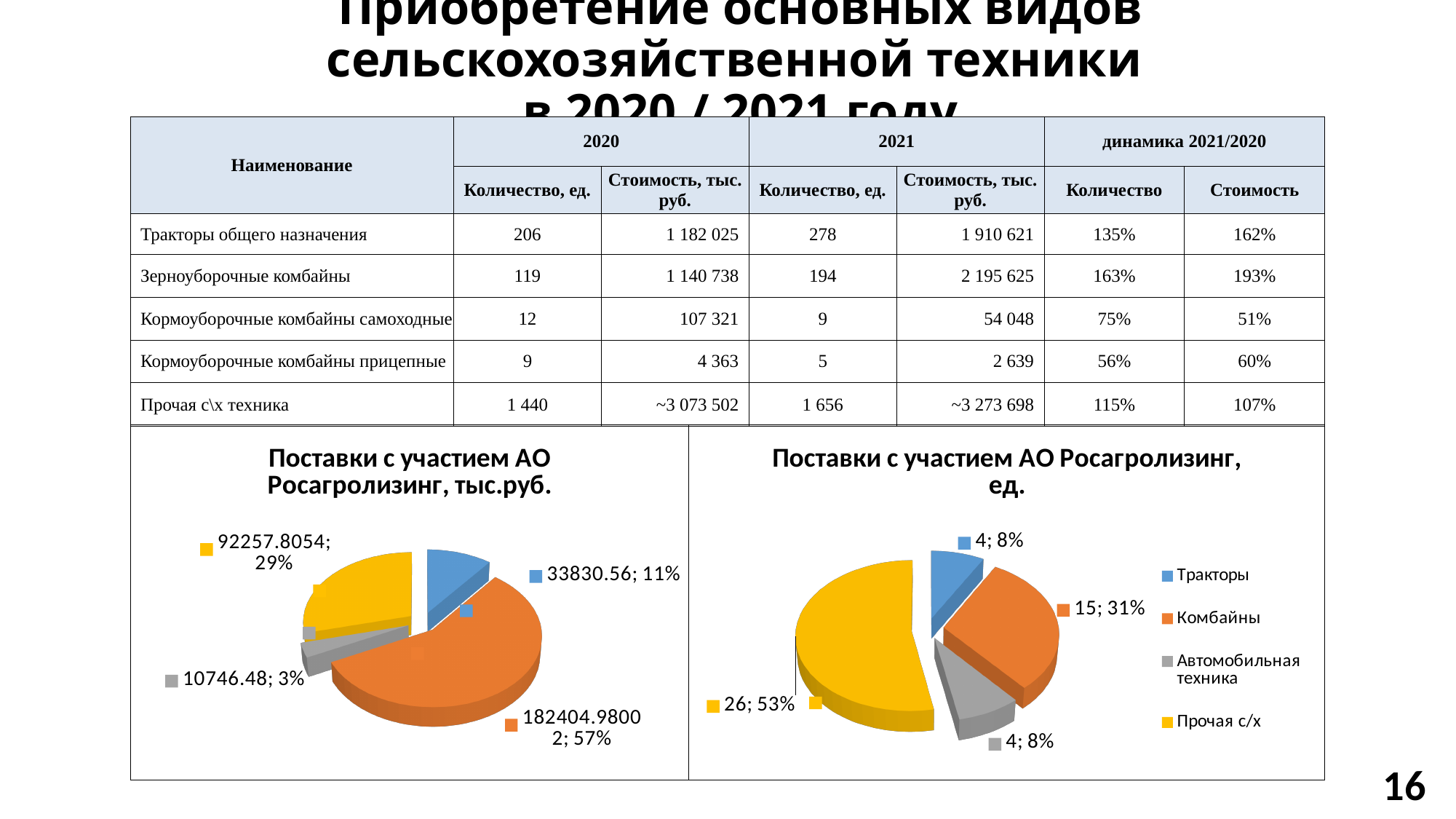
In the right-hand chart ("Поставки с участием АО Росагролизинг, ед."), what is the difference between the values for Прочая с/х and Комбайны? 11 In the right-hand chart ("Поставки с участием АО Росагролизинг, ед."), which is larger: Тракторы or Комбайны? Комбайны How many slices does the left-hand chart ("Поставки с участием АО Росагролизинг, тыс.руб.") have? 4 In the right-hand chart ("Поставки с участием АО Росагролизинг, ед."), which category has the largest slice? Прочая с/х In the left-hand chart ("Поставки с участием АО Росагролизинг, тыс.руб."), what is the value of the largest slice? 182404.98002 In the right-hand chart ("Поставки с участием АО Росагролизинг, ед."), what share of the pie does Тракторы take? 8% What kind of chart is the right-hand chart titled "Поставки с участием АО Росагролизинг, ед."? pie chart How many entries does the legend of the right-hand chart ("Поставки с участием АО Росагролизинг, ед.") list? 4 In the left-hand chart ("Поставки с участием АО Росагролизинг, тыс.руб."), what is the value of the blue slice? 33830.56 In the left-hand chart ("Поставки с участием АО Росагролизинг, тыс.руб."), what share does the smallest slice take? 3% In the right-hand chart ("Поставки с участием АО Росагролизинг, ед."), what is the value for Комбайны? 15 In the right-hand chart ("Поставки с участием АО Росагролизинг, ед."), what share of the pie does Прочая с/х take? 53%